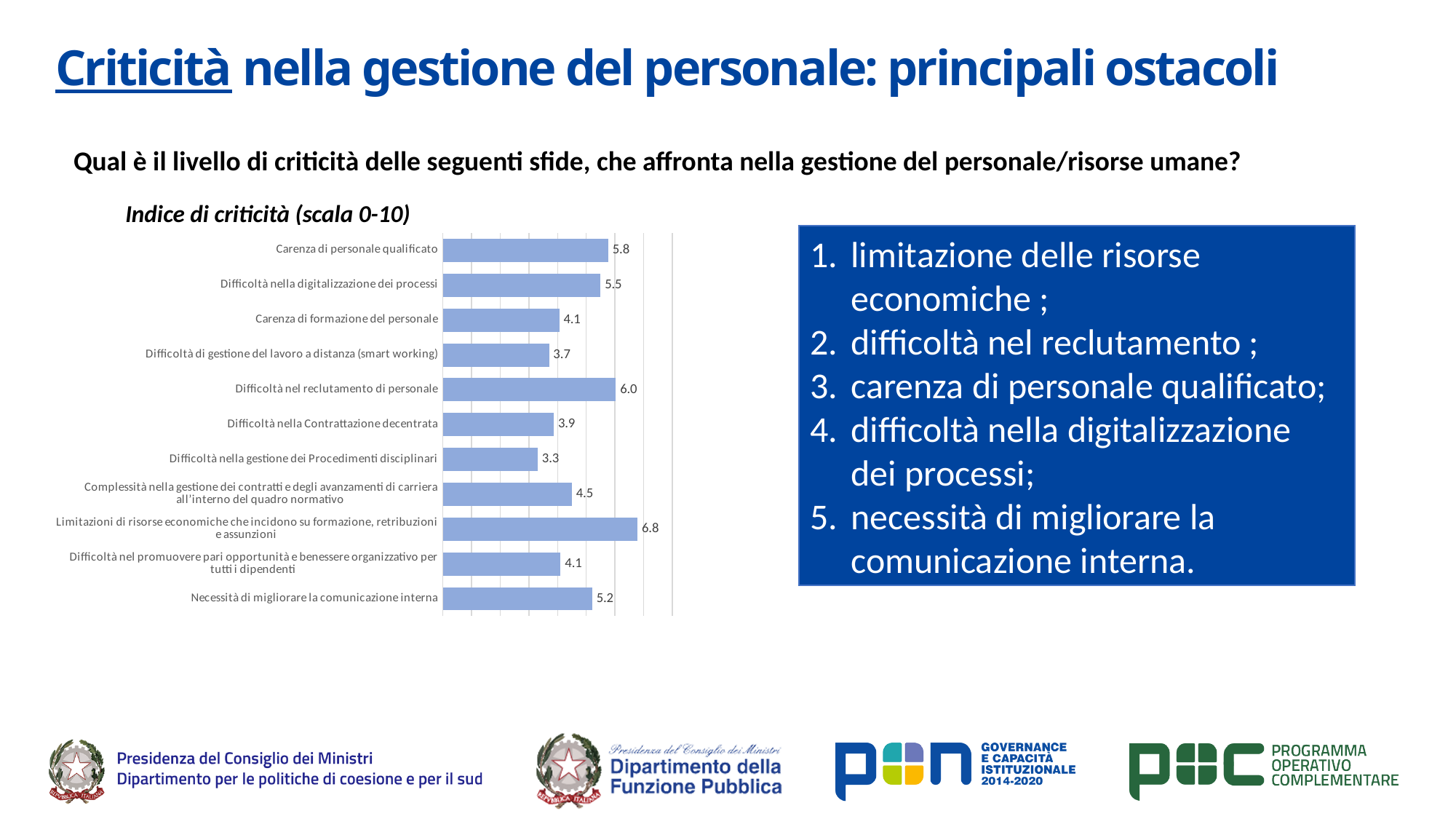
How many categories are shown in the chart? 11 Which has a higher criticality index: 'Difficoltà di gestione del lavoro a distanza (smart working)' or 'Difficoltà nella Contrattazione decentrata'? Difficoltà nella Contrattazione decentrata What is the criticality index for 'Carenza di personale qualificato'? 5.8 Which category has the highest criticality index? Limitazioni di risorse economiche che incidono su formazione, retribuzioni e assunzioni What is the difference between the criticality index for 'Limitazioni di risorse economiche che incidono su formazione, retribuzioni e assunzioni' and 'Difficoltà nel reclutamento di personale'? 0.8 What is the criticality index for 'Difficoltà nel reclutamento di personale'? 6.0 Which category has the lowest criticality index? Difficoltà nella gestione dei Procedimenti disciplinari What is the criticality index for 'Difficoltà nella gestione dei Procedimenti disciplinari'? 3.3 What type of chart is shown on the slide? Bar chart What is the title of the chart? Indice di criticità (scala 0-10) What is the criticality index for 'Necessità di migliorare la comunicazione interna'? 5.2 What is the difference between the criticality index for 'Carenza di personale qualificato' and 'Difficoltà nella digitalizzazione dei processi'? 0.3